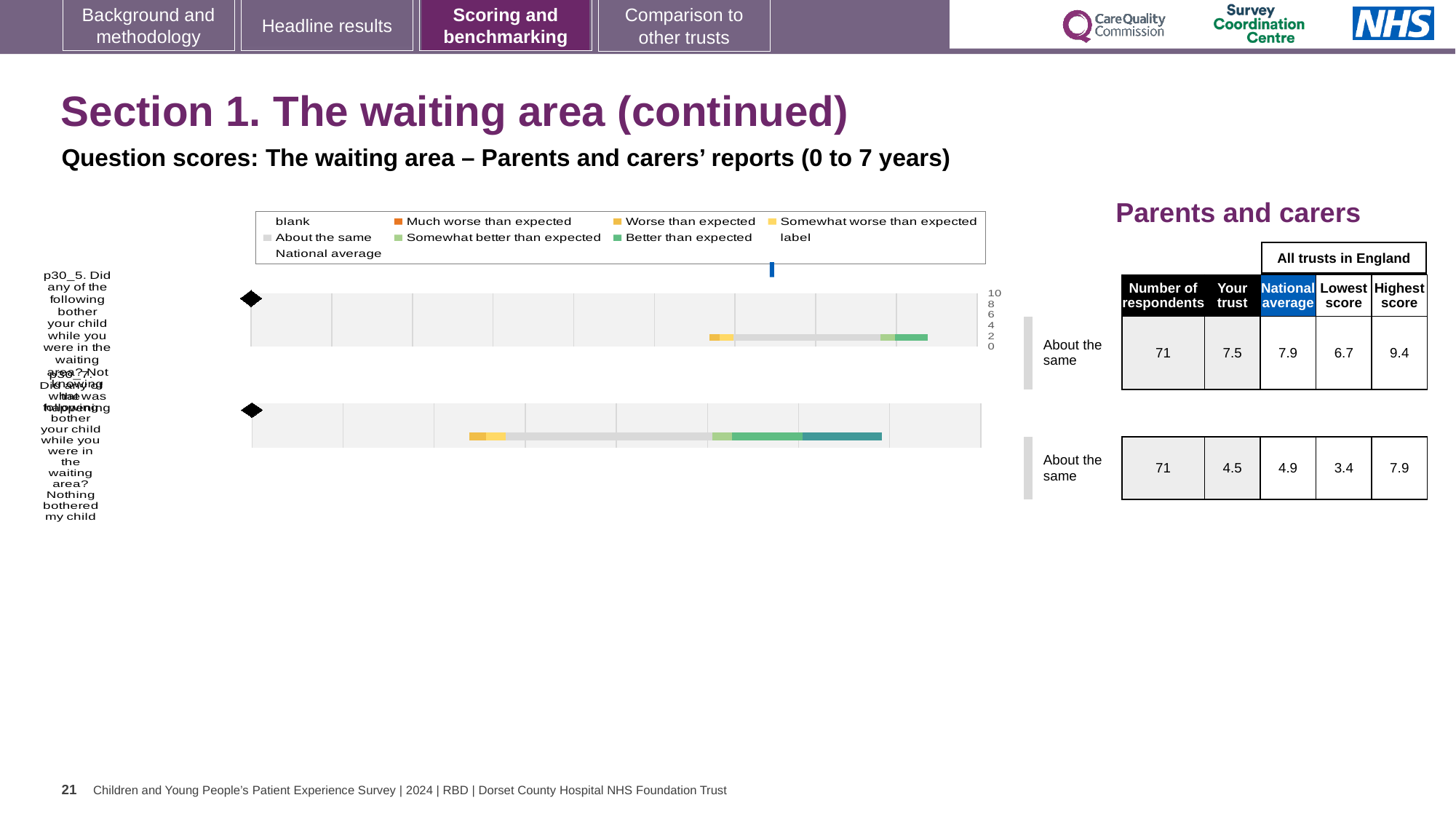
What is the 'Your trust' score for question p30_5 (Did any of the following bother your child while you were in the waiting area? Not knowing what was happening)? 7.5 What is the 'Your trust' score for question p30_7 (Nothing bothered my child)? 4.5 What is the national average score for question p30_5? 7.9 What kind of chart is used to show the question scores on this slide? bar chart How many respondents answered question p30_7? 71 What is the lowest score among all trusts in England for question p30_7? 3.4 What benchmark category is shown next to the bar for question p30_5? About the same How many questions (bars) are plotted in the chart on this slide? 2 For question p30_5, which is larger: the 'Your trust' score or the national average? National average Which of the two questions has the higher 'Your trust' score? p30_5 What is the difference between the highest score and the lowest score for question p30_7? 4.5 What is the highest score among all trusts in England for question p30_5? 9.4